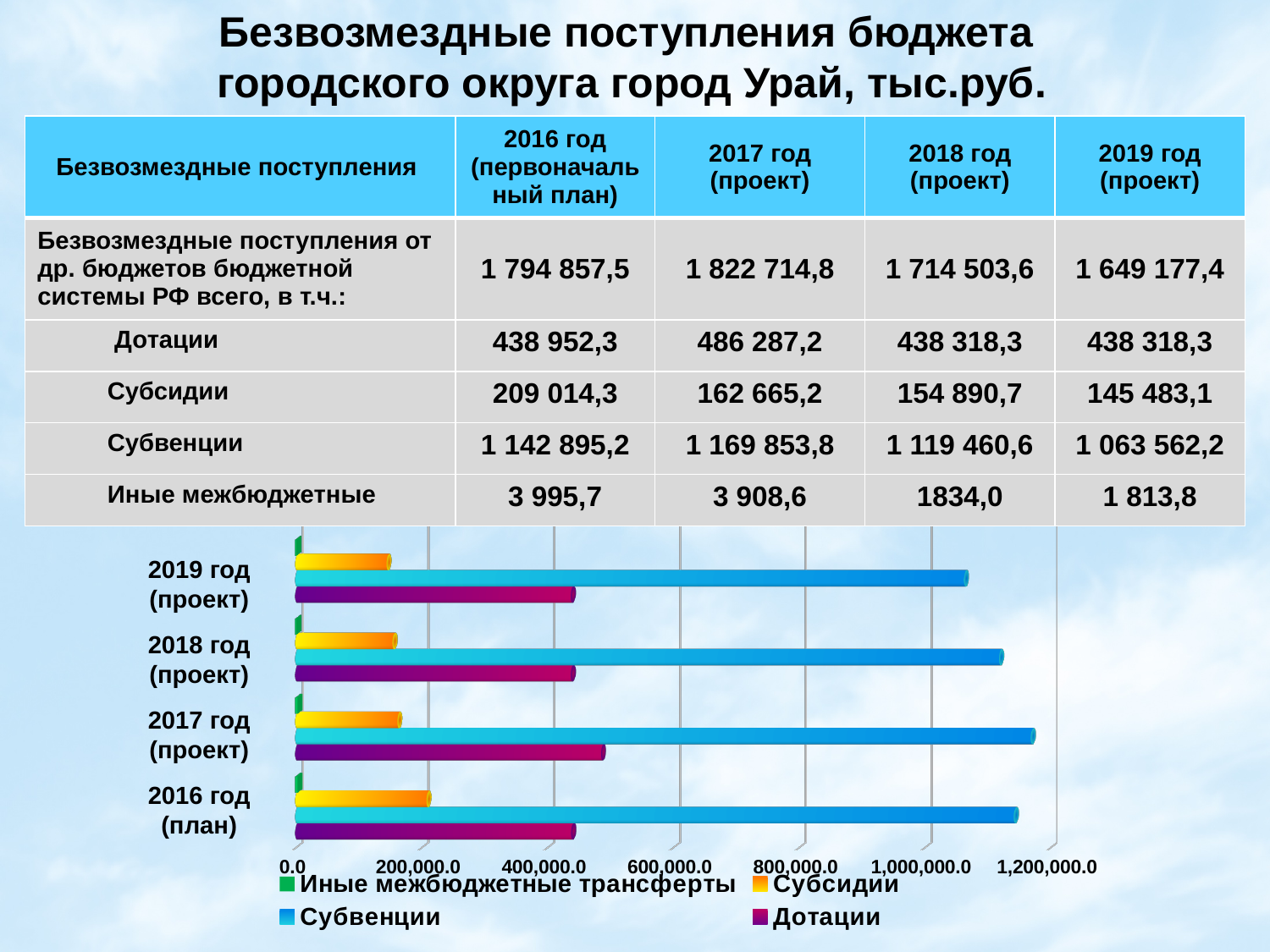
How many year categories does the bar chart show? 4 In the bar chart, is the value for Субвенции in 2017 год (проект) greater or less than 1,000,000.0? greater In the bar chart, which year has the highest value for Субсидии? 2016 год (план) In the bar chart, is the value for Дотации in 2017 год (проект) greater or less than 400,000.0? greater In the bar chart, which year has the highest value for Дотации? 2017 год (проект) In the bar chart, is the value for Субсидии in 2019 год (проект) greater or less than 200,000.0? less What kind of chart is shown at the bottom of the slide? bar chart How many series does the legend of the bar chart list? 4 In the bar chart legend, which colour represents Субвенции? blue In the bar chart, do the values for Субсидии rise or fall from 2016 год (план) to 2019 год (проект)? fall In the bar chart, which is larger for 2019 год (проект): Субвенции or Дотации? Субвенции